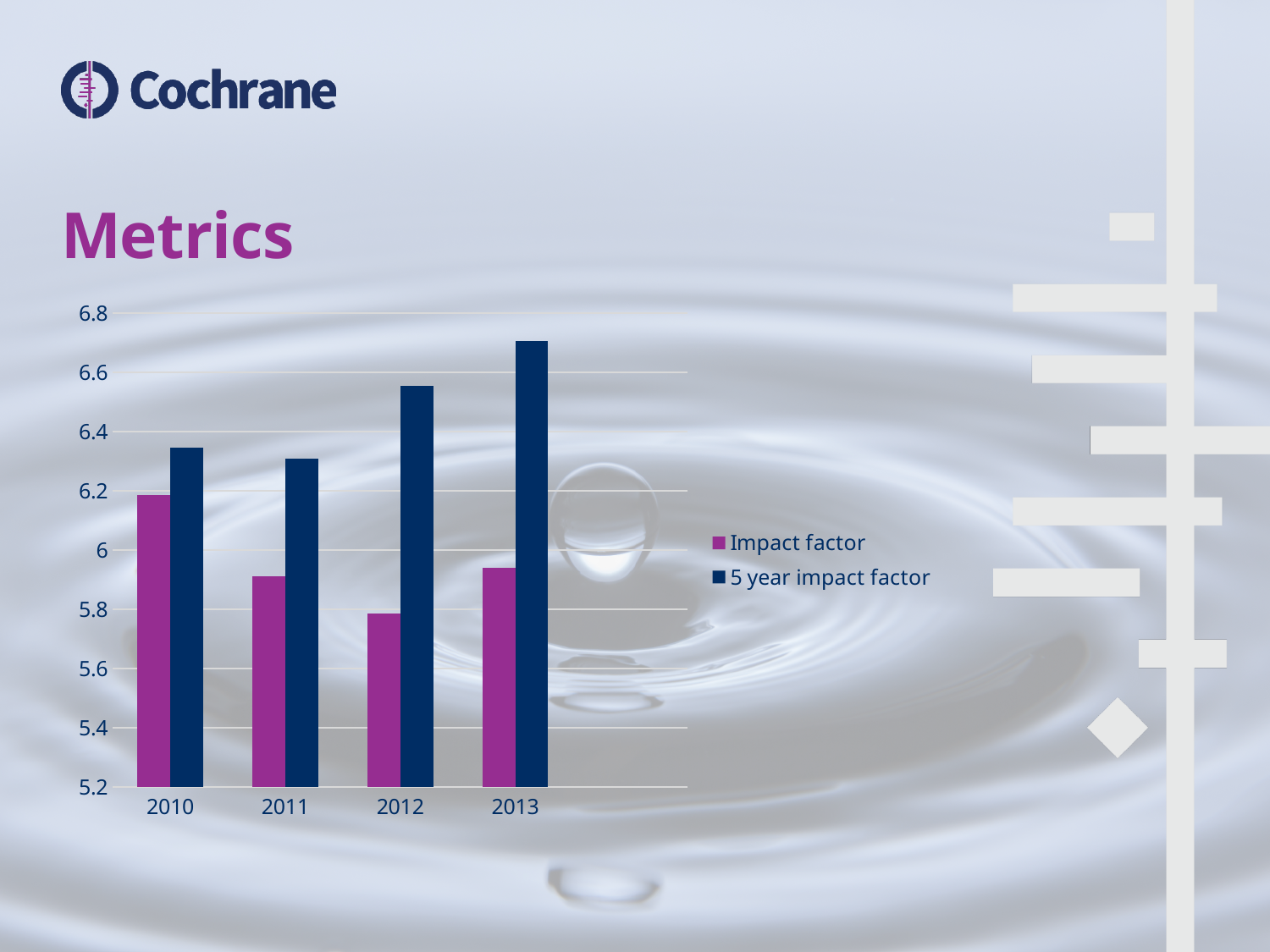
Which is larger, the Impact factor for 2010 or the Impact factor for 2013? 2010 Which year has the highest 5 year impact factor? 2013 Is the 5 year impact factor for 2013 greater or less than 6.6? greater Which year has the highest Impact factor? 2010 How many years are shown on the x axis? 4 What is the title of the slide? Metrics Is the 5 year impact factor for 2012 greater or less than 6.4? greater Does the 5 year impact factor rise or fall from 2011 to 2013? rise How many series does the legend list? 2 Is the Impact factor for 2012 greater or less than 6? less What kind of chart is shown on the slide? bar chart Which year has the lowest Impact factor? 2012